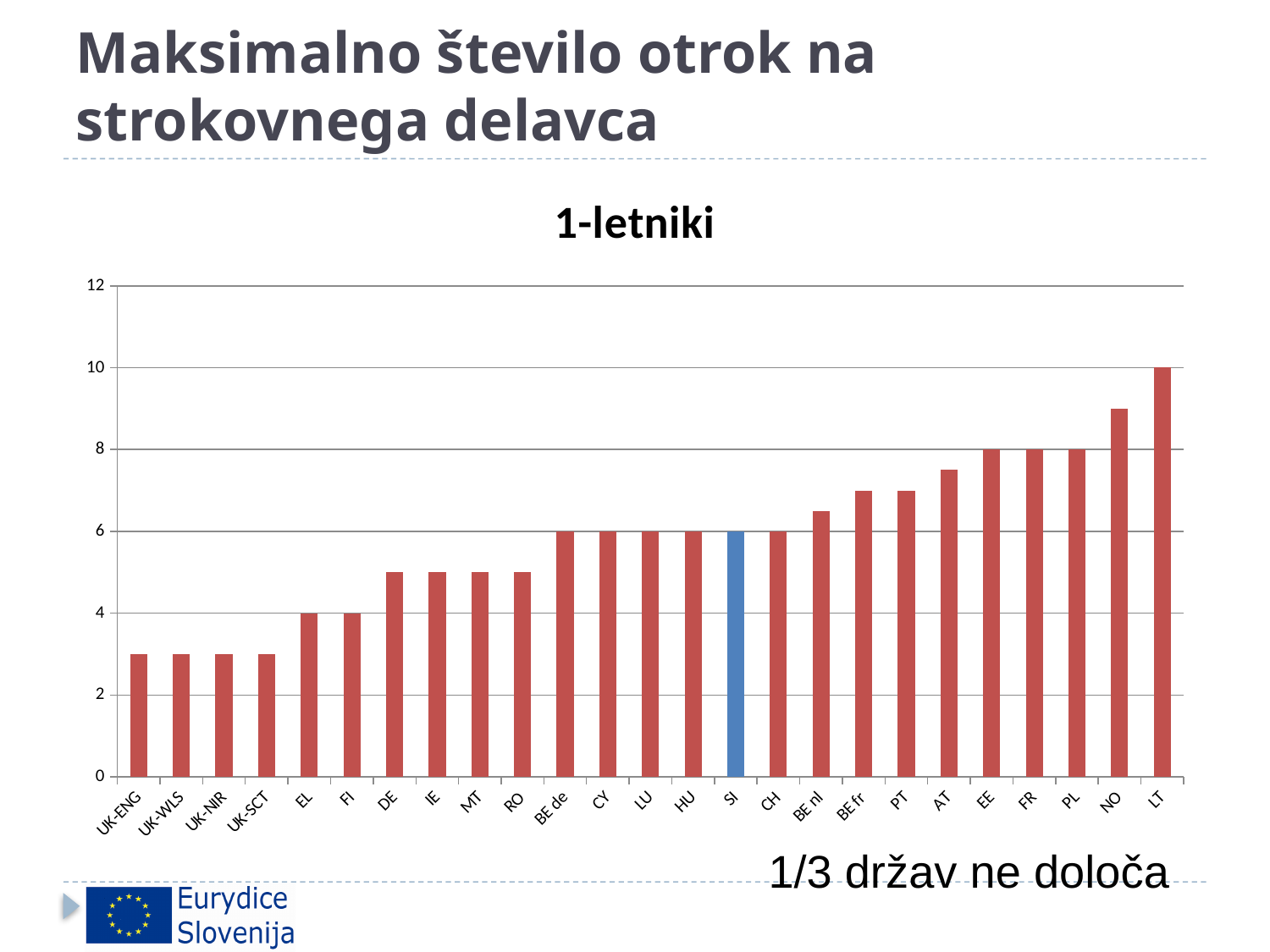
What kind of chart is shown on the slide? bar chart What is the difference between the values for LT and SI? 4 What is the value for LT? 10 Is the value for UK-ENG greater or less than 4? less Is the value for NO greater or less than 8? greater What is the value for EL? 4 Which is larger, the value for AT or the value for DE? AT What is the value for FR? 8 What is the value for SI? 6 Which category has the highest value? LT What is the title of the chart? 1-letniki How many categories are shown on the x axis? 25